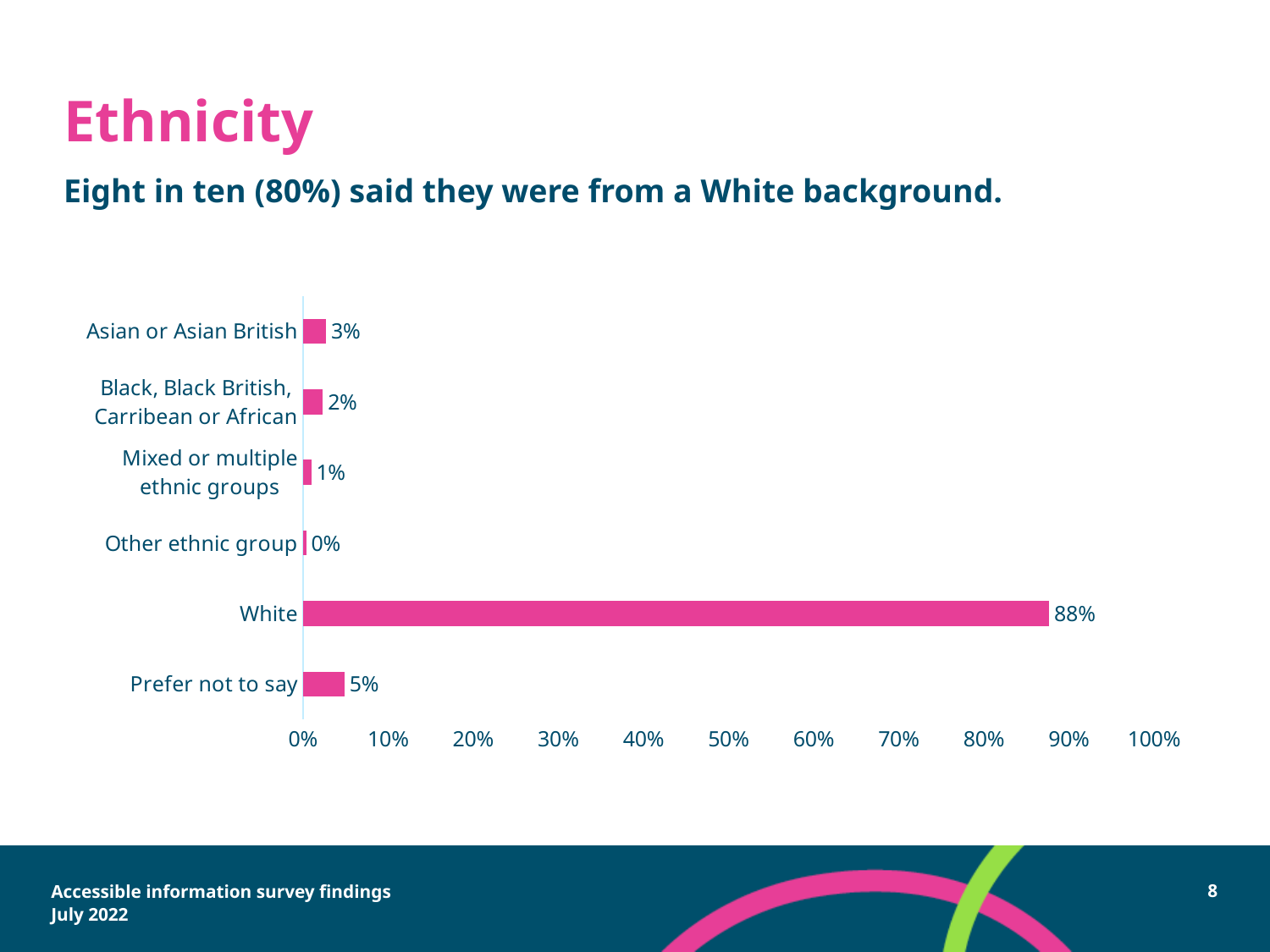
What is the title of the slide? Ethnicity Which category has the lowest value? Other ethnic group What is the difference between the White value and the Prefer not to say value? 83% What kind of chart is shown on the slide? Bar chart What percentage chose Prefer not to say? 5% What is the value for Mixed or multiple ethnic groups? 1% Which category has the highest value? White How many categories are shown in the chart? 6 What percentage of respondents said they were White? 88% Which is larger, the value for Asian or Asian British or the value for Black, Black British, Carribean or African? Asian or Asian British Is the value for White greater or less than 80%? greater What is the value for Asian or Asian British? 3%